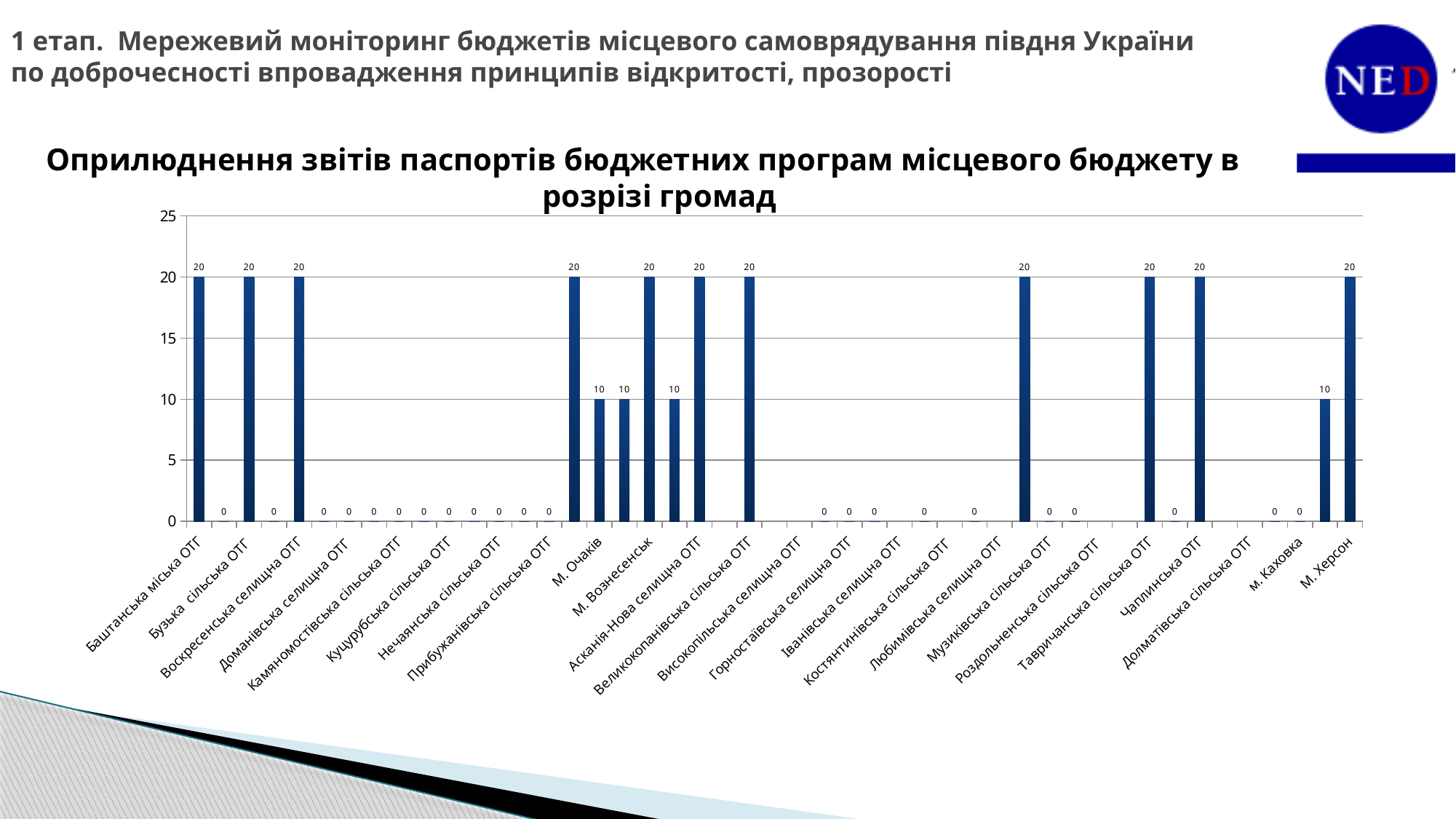
Which is larger, the value for Баштанська міська ОТГ or the value for М. Очаків? Баштанська міська ОТГ What is the value for М. Вознесенськ? 20 What is the value for Баштанська міська ОТГ? 20 What is the maximum value shown on the vertical axis? 25 What is the value for Чаплинська ОТГ? 20 What is the value for М. Херсон? 20 What kind of chart is shown on the slide? bar chart Is the value for М. Очаків greater or less than 15? less What is the difference between the value for Баштанська міська ОТГ and the value for М. Очаків? 10 What is the highest value plotted on the chart? 20 What is the value for Доманівська селищна ОТГ? 0 What is the value for М. Очаків? 10